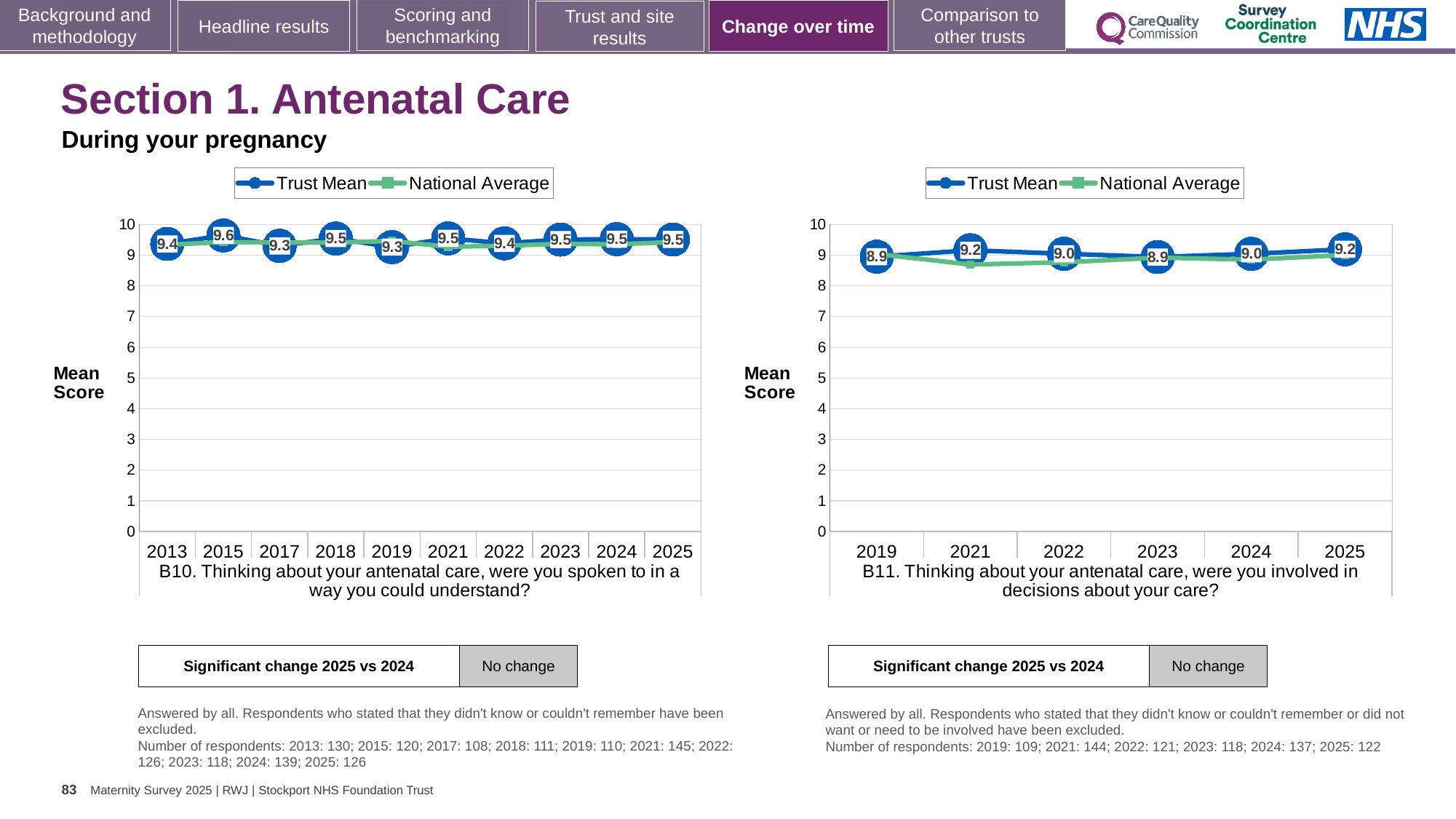
On the B11 chart (right), what is the highest Trust Mean value shown? 9.2 On the B10 chart (left), which year has the larger Trust Mean, 2015 or 2019? 2015 On the B11 chart (right), is the National Average value for 2021 greater or less than 8? greater On the B10 chart (left), what is the Trust Mean value for 2015? 9.6 On the B11 chart (right), what is the difference between the Trust Mean in 2021 and in 2022? 0.2 On the B10 chart (left), in which year is the Trust Mean highest? 2015 What type of chart is the B10 chart (left)? Line chart How many series does the legend of the B11 chart (right) list? 2 On the B11 chart (right), what is the Trust Mean value for 2023? 8.9 How many years are plotted on the B10 chart (left)? 10 On the B11 chart (right), does the Trust Mean rise or fall from 2023 to 2025? Rise On the B10 chart (left), what is the difference between the Trust Mean in 2015 and in 2017? 0.3